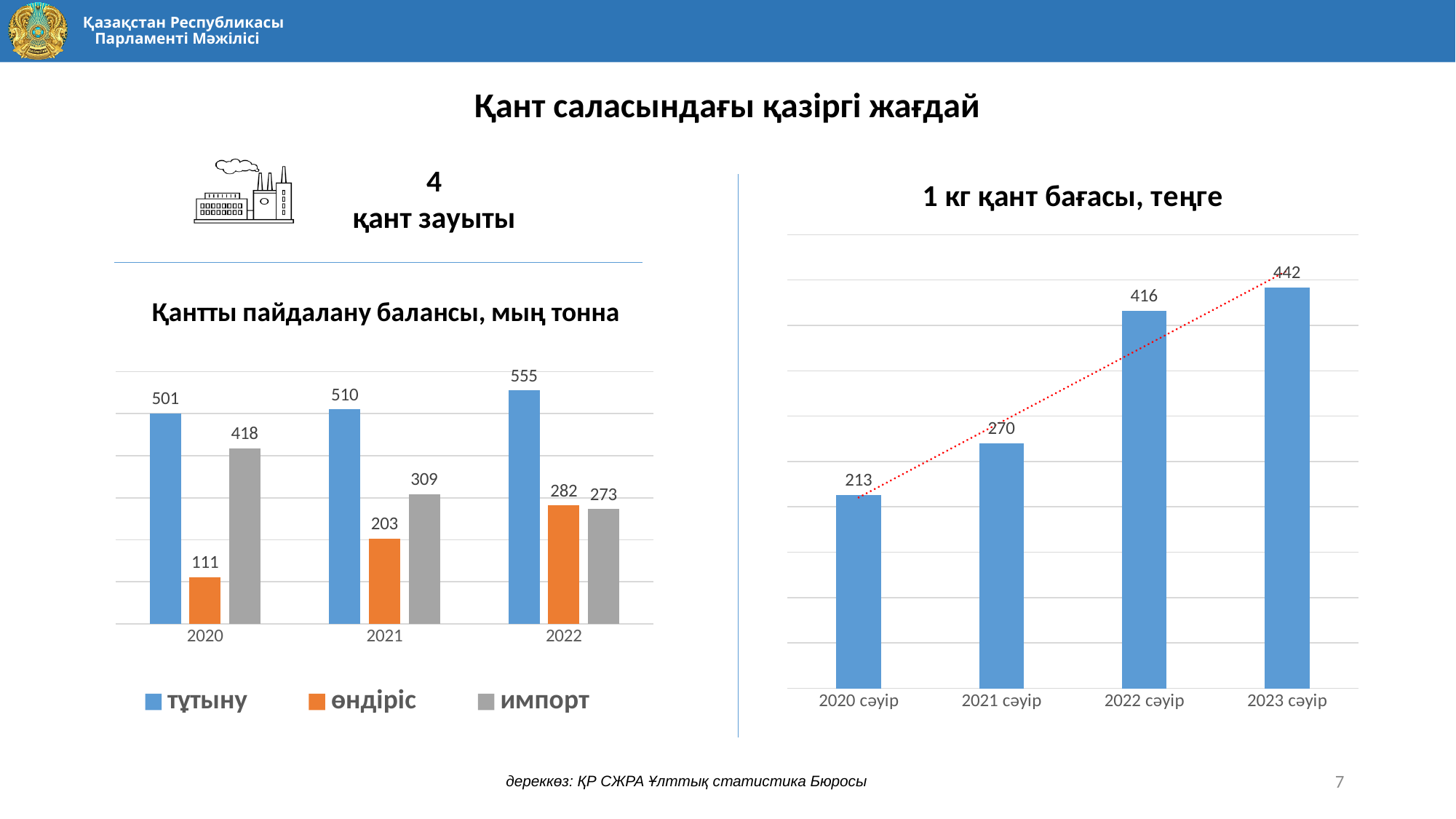
In the chart 'Қантты пайдалану балансы, мың тонна', what is the value of тұтыну for 2022? 555 In the chart 'Қантты пайдалану балансы, мың тонна', what is the value of өндіріс for 2020? 111 In the chart 'Қантты пайдалану балансы, мың тонна', which year has the highest өндіріс value? 2022 In the chart '1 кг қант бағасы, теңге', what is the difference between 2023 сәуір and 2020 сәуір? 229 In the chart 'Қантты пайдалану балансы, мың тонна', what is the difference between тұтыну and импорт in 2020? 83 In the chart '1 кг қант бағасы, теңге', which period has the lowest value? 2020 сәуір In the chart 'Қантты пайдалану балансы, мың тонна', which is larger in 2022: өндіріс or импорт? өндіріс In the chart 'Қантты пайдалану балансы, мың тонна', how many series does the legend list? 3 In the chart '1 кг қант бағасы, теңге', do the values rise or fall from 2020 сәуір to 2023 сәуір? rise In the chart '1 кг қант бағасы, теңге', what is the value for 2021 сәуір? 270 What kind of chart is '1 кг қант бағасы, теңге'? bar chart In the chart 'Қантты пайдалану балансы, мың тонна', what is the value of импорт for 2021? 309